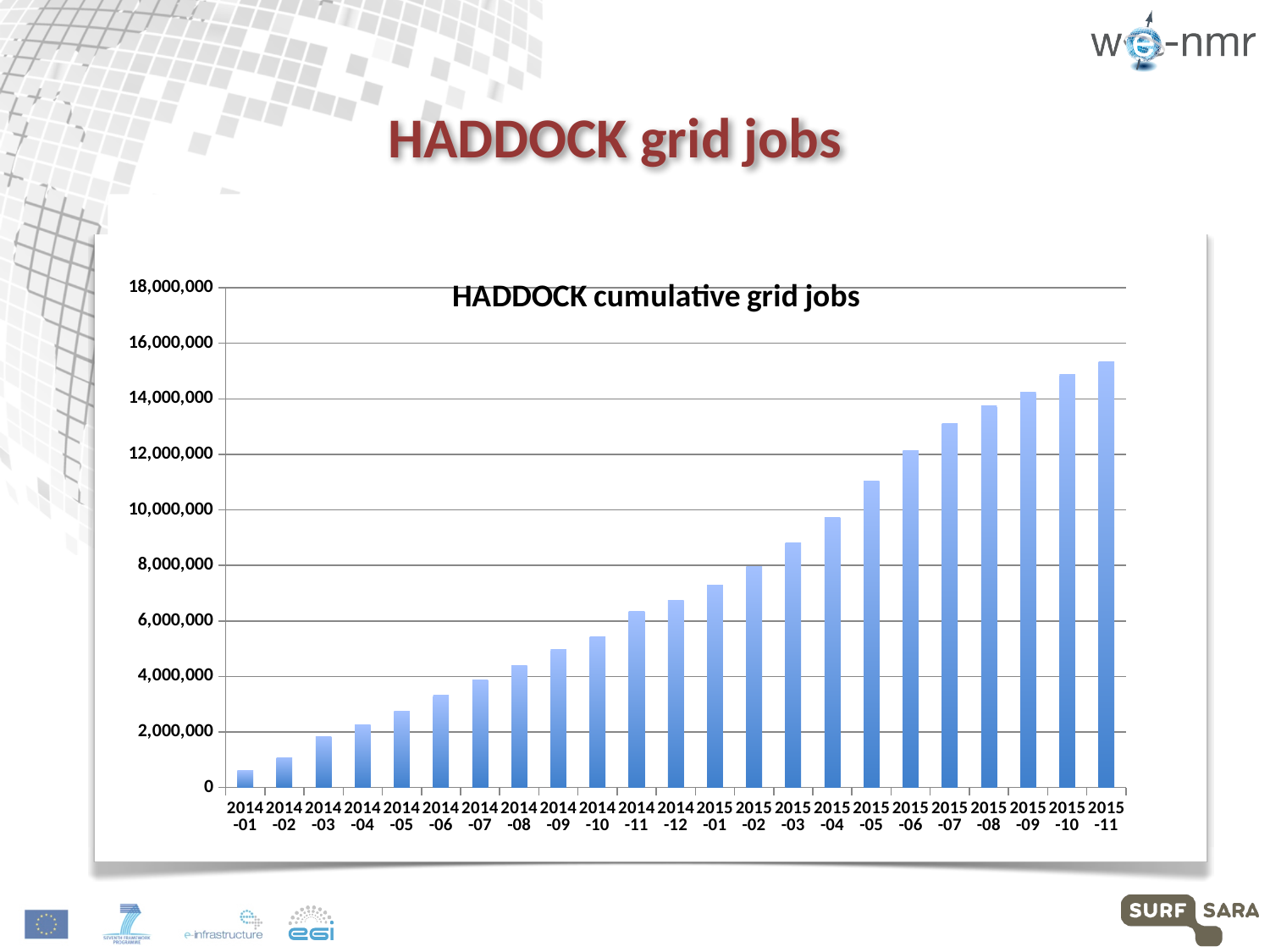
How many months (bars) are plotted on the x axis? 23 What is the title of the chart? HADDOCK cumulative grid jobs Which is larger, the value for 2015-03 or the value for 2014-06? 2015-03 Is the value for 2015-11 greater or less than 14,000,000? greater Is the value for 2014-01 greater or less than 2,000,000? less Is the value for 2014-09 greater or less than 4,000,000? greater Do the values rise or fall from 2014-01 to 2015-11? rise What kind of chart is shown on the slide? bar chart Which month has the highest value? 2015-11 Which month has the lowest value? 2014-01